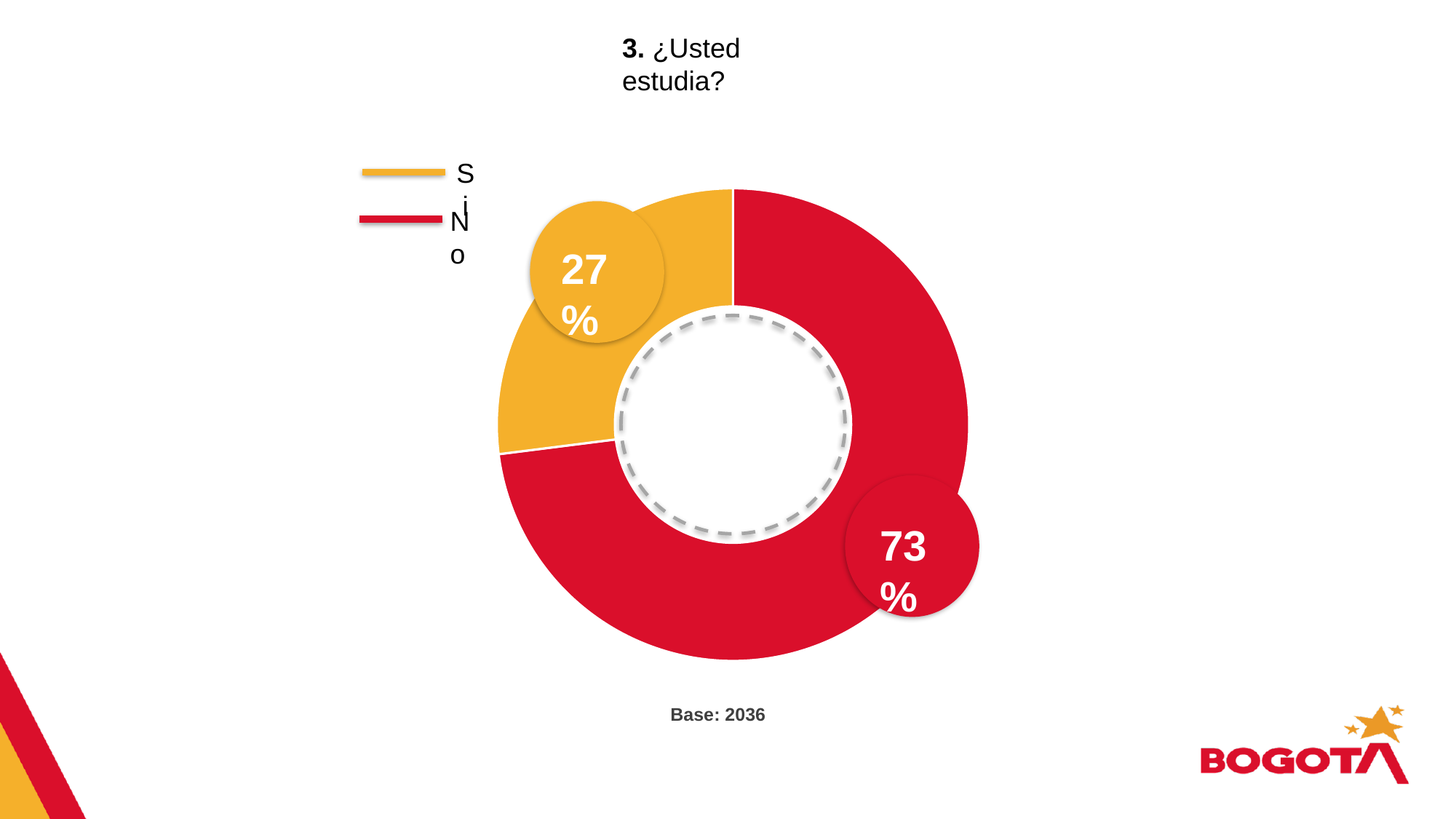
Which response has the largest share of the pie? No How many entries does the legend list? 2 What percentage of respondents answered "Sí" to the question "¿Usted estudia?"? 27% What is the difference in percentage points between the "No" and "Sí" responses? 46 How many categories are shown in the chart? 2 Which response has the smallest share of the pie? Sí What is the base (number of respondents) stated below the chart? 2036 What colour represents the "No" response in the chart? Red What is the total of the two percentages shown in the chart? 100% Which is larger, the share for "Sí" or the share for "No"? No What kind of chart is shown on the slide? Pie chart (doughnut) What percentage of respondents answered "No" to the question "¿Usted estudia?"? 73%